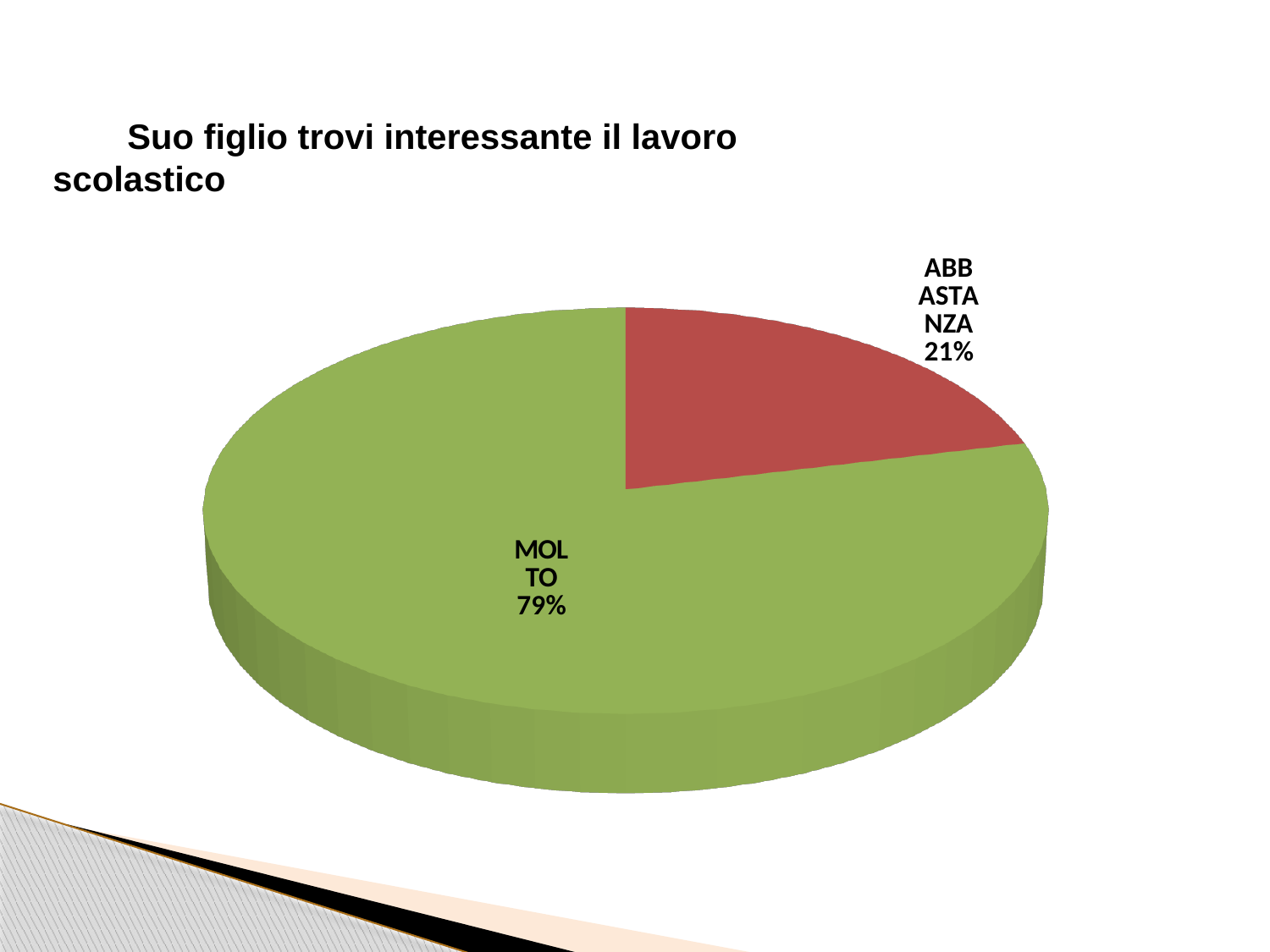
What share of the pie does ABBASTANZA represent? 21% What is the difference in percentage points between the MOLTO and ABBASTANZA slices? 58 Which slice of the pie is the smallest? ABBASTANZA What kind of chart is shown on the slide? pie chart What share of the pie does MOLTO represent? 79% What is the title of the slide? Suo figlio trovi interessante il lavoro scolastico What colour is the MOLTO slice? green How many slices does the pie chart have? 2 Which is larger, the MOLTO slice or the ABBASTANZA slice? MOLTO Which slice of the pie is the largest? MOLTO